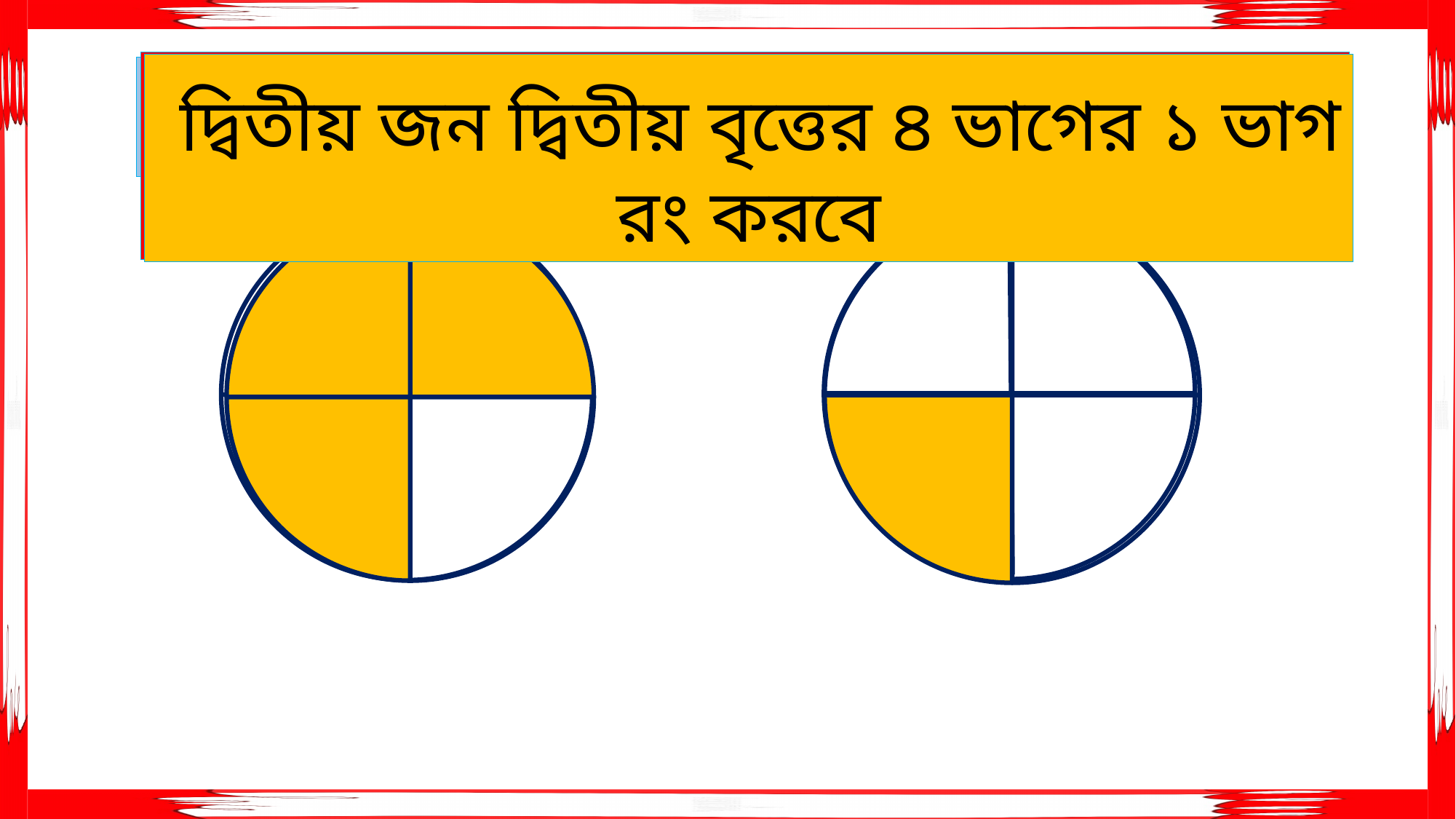
How many more yellow parts does the left circle have than the right circle? 2 How many circles are shown on the slide? 2 Which circle has more yellow-coloured parts, the left or the right? left How many parts of the right circle are coloured yellow? 1 How many parts of the left circle are coloured yellow? 3 What colour are the shaded parts of the circles? yellow What fraction of the left circle is coloured yellow? 3/4 Which part of the right circle is coloured: the bottom-left or the top-right? bottom-left What fraction of the right circle is coloured yellow? 1/4